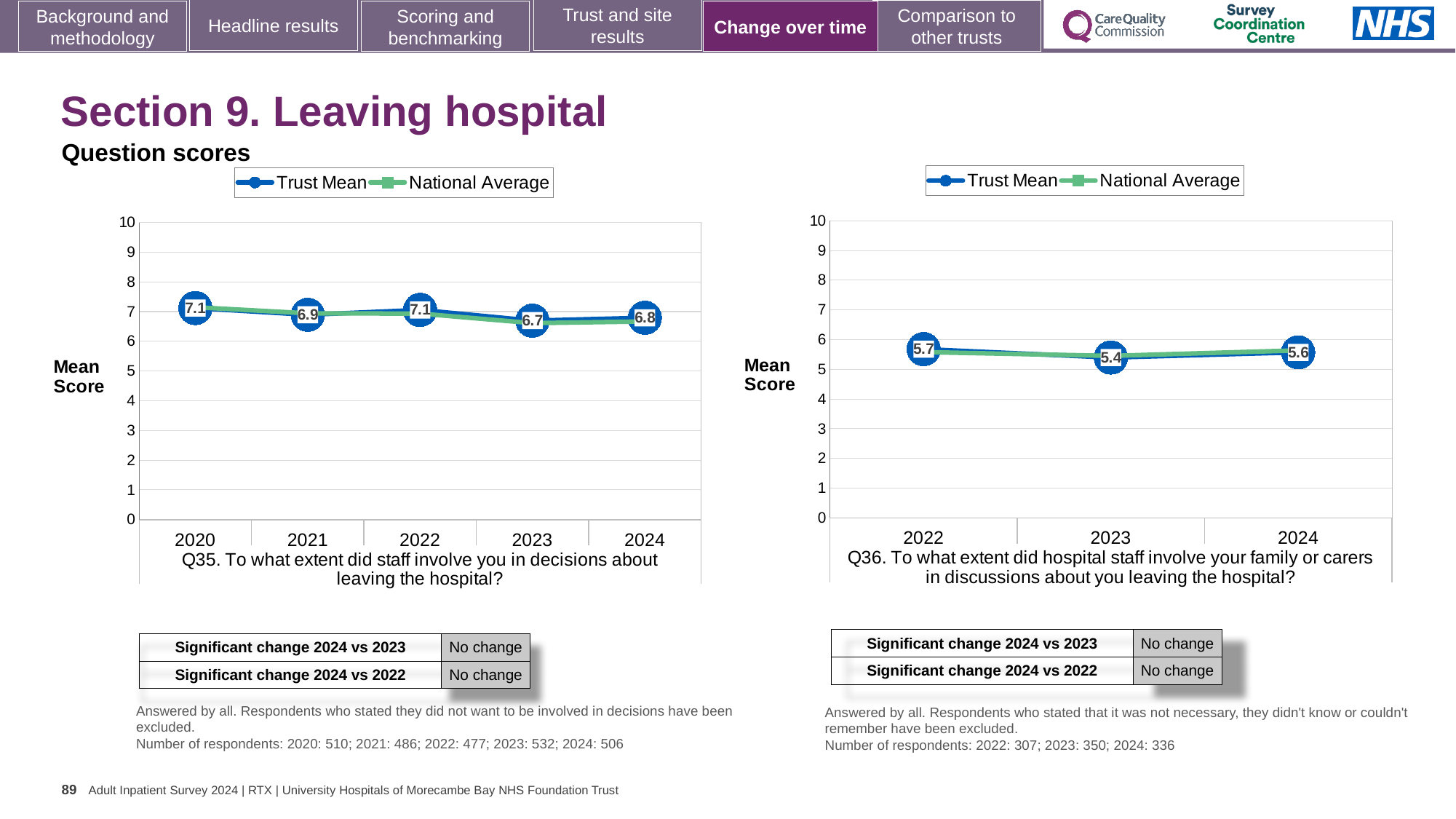
In the Q36 chart on the right, what is the Trust Mean score for 2024? 5.6 In the Q35 chart on the left, what is the Trust Mean score for 2023? 6.7 How many series does the legend of the Q36 chart on the right list? 2 What type of chart is the Q35 chart on the left? line chart In the Q36 chart on the right, which year has the lowest Trust Mean score? 2023 In the Q35 chart on the left, is the Trust Mean score for 2021 higher or lower than for 2024? higher In the Q36 chart on the right, what is the difference between the Trust Mean scores for 2022 and 2023? 0.3 In the Q35 chart on the left, what is the difference between the Trust Mean scores for 2022 and 2023? 0.4 In the Q36 chart on the right, is the Trust Mean score for 2022 greater or less than 5? greater In the Q35 chart on the left, which year has the lowest Trust Mean score? 2023 How many years are plotted on the x axis of the Q35 chart on the left? 5 In the Q35 chart on the left, what is the Trust Mean score for 2020? 7.1